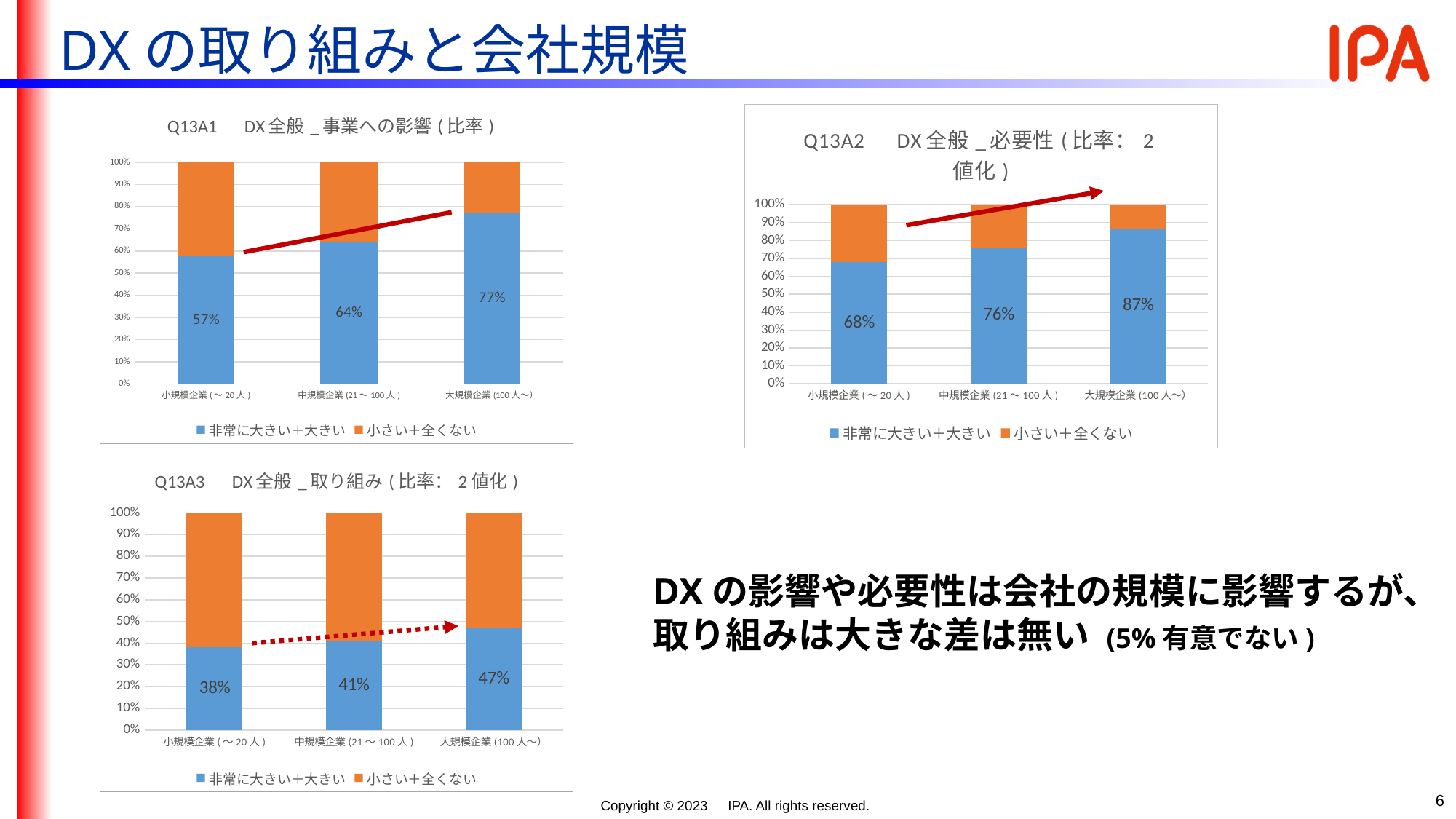
In the Q13A2 chart (DX全般_必要性), what is the difference between the 非常に大きい＋大きい values for 大規模企業(100人～) and 小規模企業(～20人)? 19% In the Q13A1 chart (DX全般_事業への影響), what is the value of 非常に大きい＋大きい for 大規模企業(100人～)? 77% In the Q13A1 chart (DX全般_事業への影響), what is the value of 非常に大きい＋大きい for 小規模企業(～20人)? 57% In the Q13A2 chart (DX全般_必要性), which company size has the highest 非常に大きい＋大きい value? 大規模企業(100人～) What kind of chart is the Q13A2 chart (DX全般_必要性)? stacked bar chart In the Q13A3 chart (DX全般_取り組み), is the 非常に大きい＋大きい value for 大規模企業(100人～) greater or less than 50%? less In the Q13A3 chart (DX全般_取り組み), which company size has the lowest 非常に大きい＋大きい value? 小規模企業(～20人) In the Q13A2 chart (DX全般_必要性), what is the value of 非常に大きい＋大きい for 中規模企業(21～100人)? 76% In the Q13A1 chart (DX全般_事業への影響), what is the difference between the 非常に大きい＋大きい values for 大規模企業(100人～) and 小規模企業(～20人)? 20% How many series does the legend of the Q13A1 chart list? 2 In the Q13A3 chart (DX全般_取り組み), does the 非常に大きい＋大きい value rise or fall as company size increases from left to right? rise In the Q13A3 chart (DX全般_取り組み), what is the value of 非常に大きい＋大きい for 小規模企業(～20人)? 38%